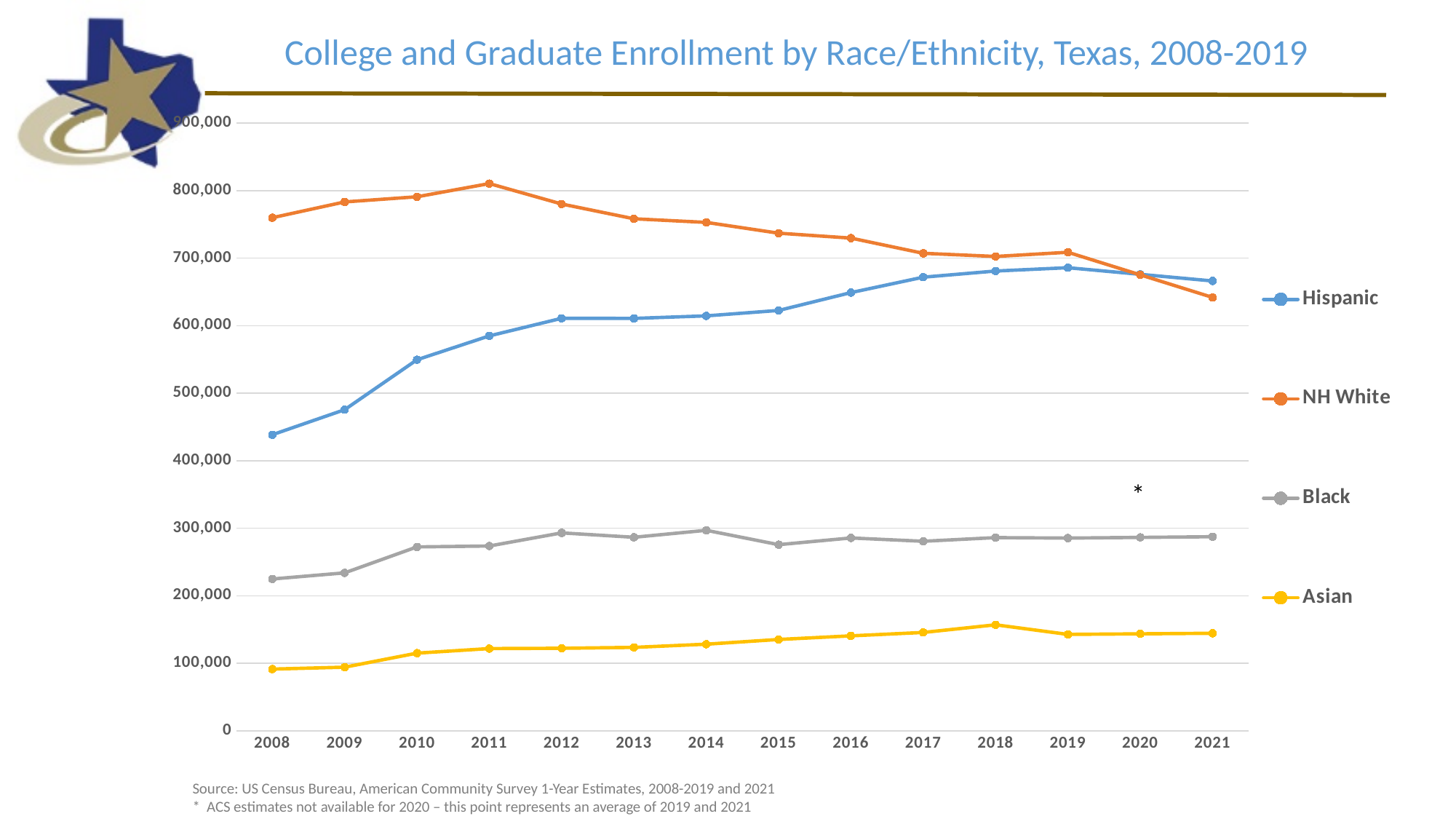
In which year is the Hispanic series at its lowest value? 2008 How many series does the legend list? 4 What is the title of the chart? College and Graduate Enrollment by Race/Ethnicity, Texas, 2008-2019 In 2021, which series is higher: Hispanic or NH White? Hispanic How many years are shown along the x axis? 14 Is the value for Asian in 2008 greater or less than 100,000? less In which year does the Asian series reach its highest value? 2018 Does the NH White series generally rise or fall from 2011 to 2021? fall In 2008, which series is higher: Hispanic or NH White? NH White What kind of chart is shown on the slide? Line chart Is the value for Hispanic in 2008 greater or less than 400,000? greater In which year does the NH White series reach its highest value? 2011